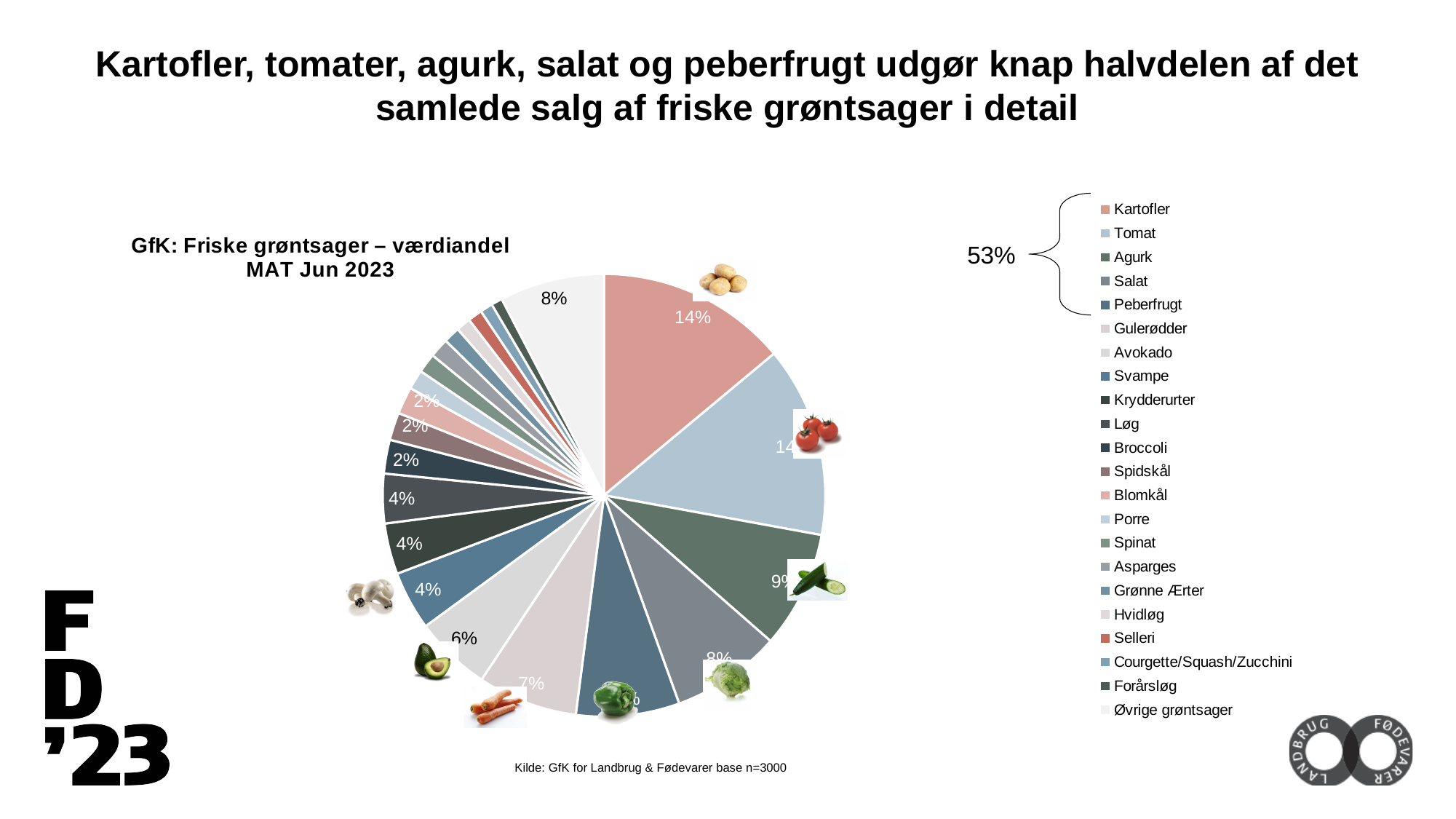
What share does Salat have in the pie chart? 8% What kind of chart is shown on the slide? Pie chart According to the bracket next to the legend, what combined share do Kartofler, Tomat, Agurk, Salat and Peberfrugt make up? 53% What share does Gulerødder have in the pie chart? 7% What share does Svampe have in the pie chart? 4% How many percentage points larger is the share of Kartofler than the share of Agurk? 5 percentage points Which has the larger share, Agurk or Salat? Agurk What share does Kartofler have in the pie chart? 14% What share does Øvrige grøntsager have in the pie chart? 8% How many categories does the legend of the pie chart list? 22 What share does Avokado have in the pie chart? 6% What share does Agurk have in the pie chart? 9%